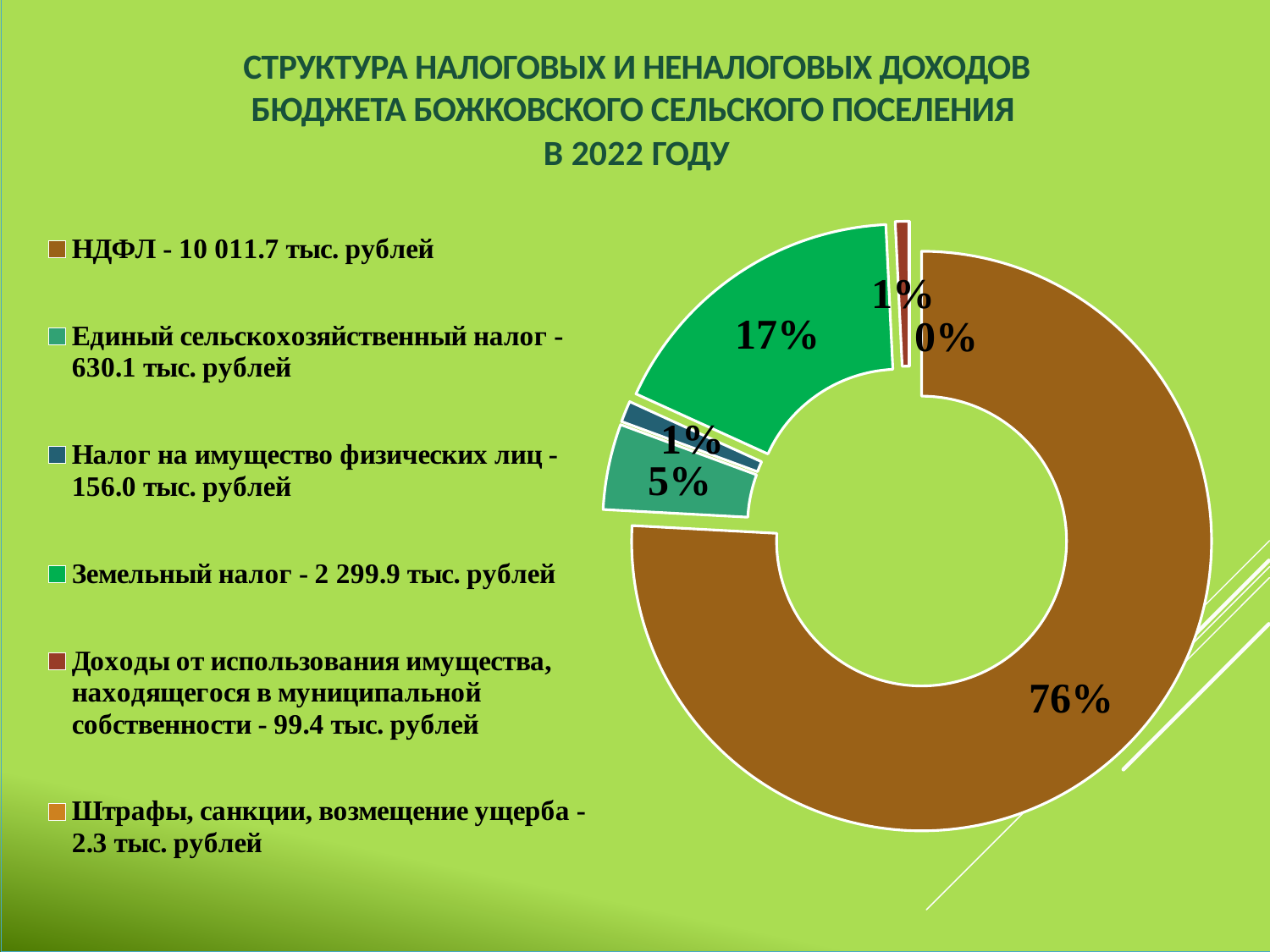
What share of the chart does Штрафы, санкции, возмещение ущерба account for? 0% Which category has the largest share of the chart? НДФЛ What is the difference in percentage points between the share of НДФЛ and the share of Земельный налог? 59 percentage points According to the legend, what is the amount for Земельный налог? 2 299.9 тыс. рублей Which category has the smallest share of the chart? Штрафы, санкции, возмещение ущерба Which is larger: the share of Земельный налог or the share of Единый сельскохозяйственный налог? Земельный налог What share of the chart does Единый сельскохозяйственный налог account for? 5% What share of the chart does Земельный налог account for? 17% How many categories does the legend list? 6 What kind of chart is shown on the slide? Doughnut (pie) chart According to the legend, what is the amount for Налог на имущество физических лиц? 156.0 тыс. рублей